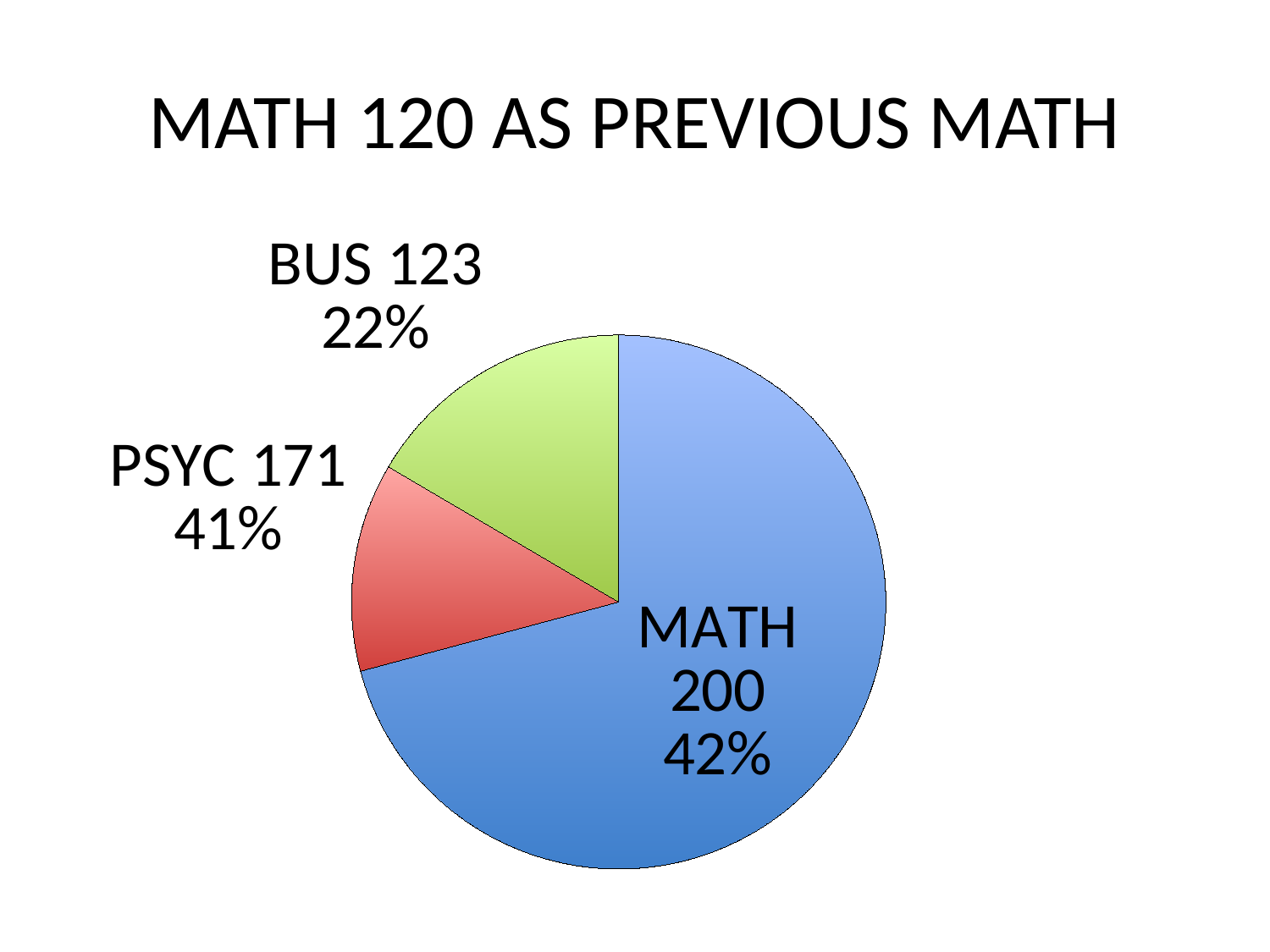
What colour is the MATH 200 slice? blue What kind of chart is shown on the slide? pie chart Which is larger, the MATH 200 slice or the BUS 123 slice? MATH 200 How many slices does the pie chart have? 3 What is the title of the chart? MATH 120 AS PREVIOUS MATH What percentage is shown for the MATH 200 slice? 42% Which slice of the pie chart is the largest? MATH 200 What percentage is shown for the BUS 123 slice? 22% What percentage is shown for the PSYC 171 slice? 41% What is the difference in percentage points between the MATH 200 slice and the BUS 123 slice? 20%